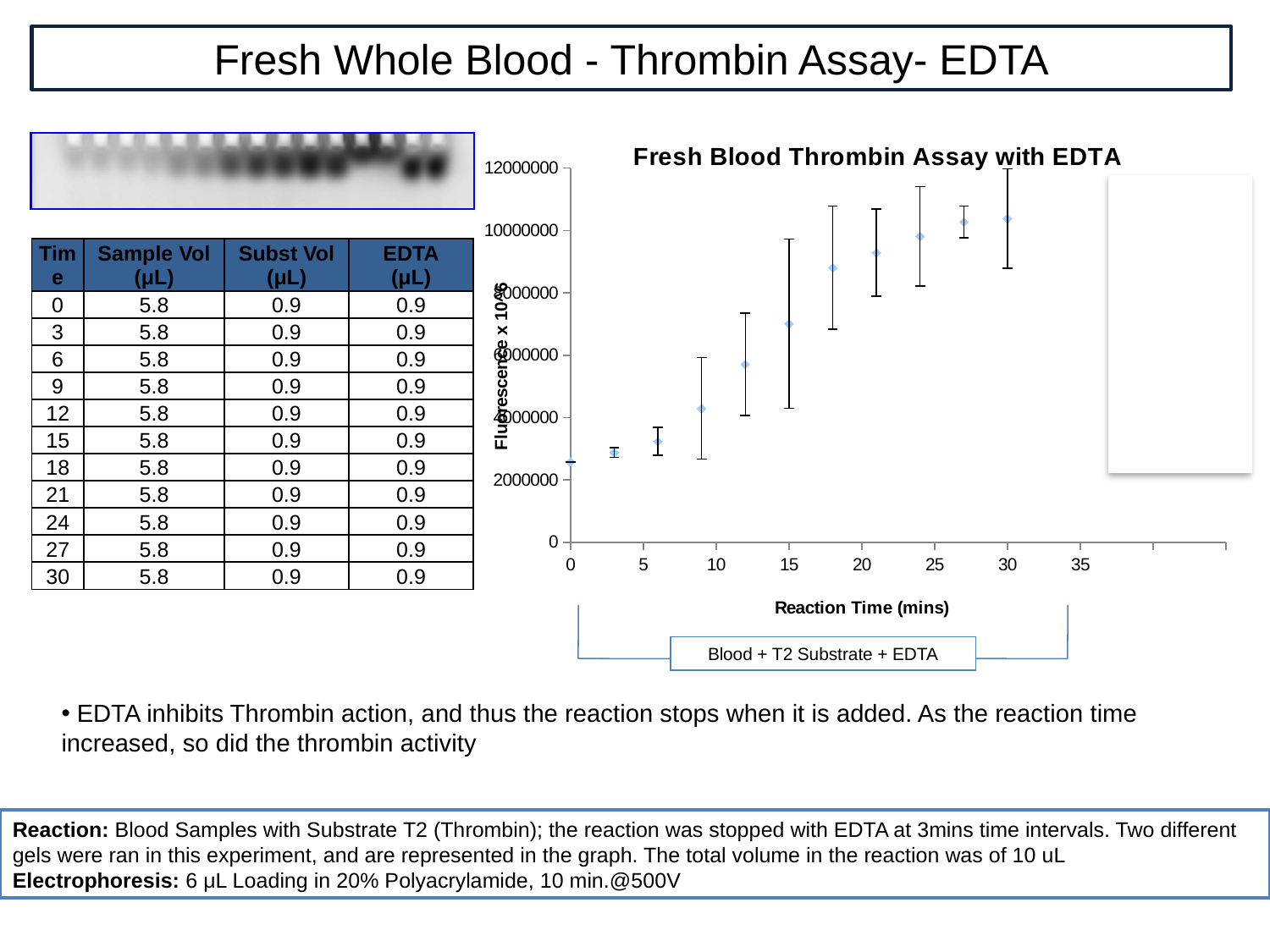
Which has the lower fluorescence value, 9 mins or 27 mins? 9 mins Is the fluorescence value at 24 mins greater or less than 8000000? greater Is the fluorescence value at 15 mins greater or less than 6000000? greater Is the fluorescence value at 0 mins greater or less than 4000000? less Do the fluorescence values generally rise or fall as reaction time increases? Rise Which has the higher fluorescence value, 18 mins or 6 mins? 18 mins What type of chart is shown on the slide? Scatter chart How many data points are plotted in the chart? 11 What is the label of the x axis of the chart? Reaction Time (mins) What is the title of the chart? Fresh Blood Thrombin Assay with EDTA